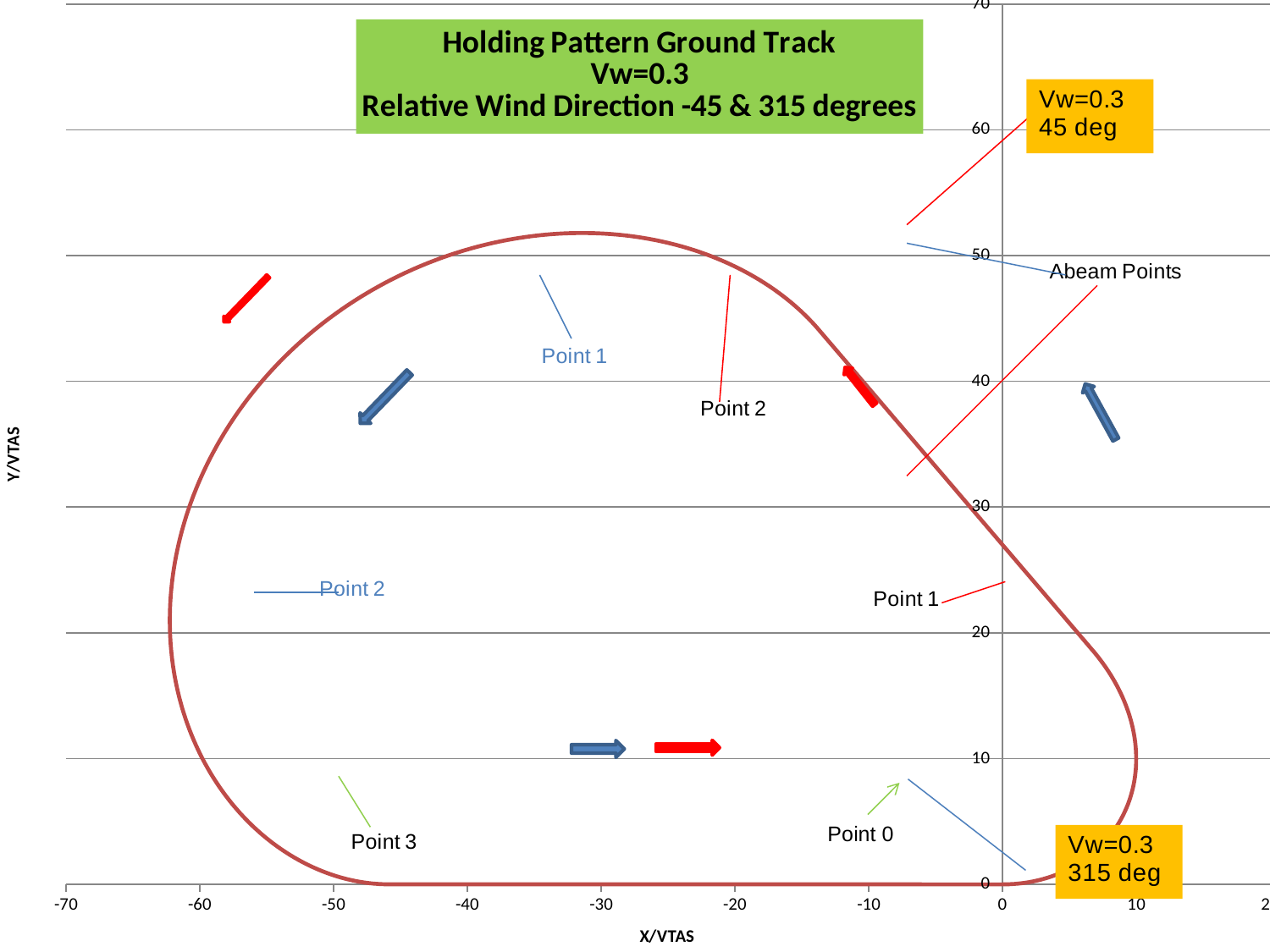
Is the Y/VTAS value of the track at the point labelled Point 3 greater or less than 10? less What is the minimum value shown on the X/VTAS axis? -70 What kind of chart is shown on the slide? line chart Is the Y/VTAS value of the track at the point labelled Point 2 on the upper right greater or less than 40? greater What is the label of the horizontal axis? X/VTAS What is the title of the chart? Holding Pattern Ground Track Vw=0.3 Relative Wind Direction -45 & 315 degrees Is the lowest X/VTAS value reached by the ground track greater or less than -60? less How many numbered points (Point 0 to Point 3) are labelled along the ground track? 4 Which has the larger Y/VTAS value on the track: the point labelled Point 1 on the upper left or the point labelled Point 3? Point 1